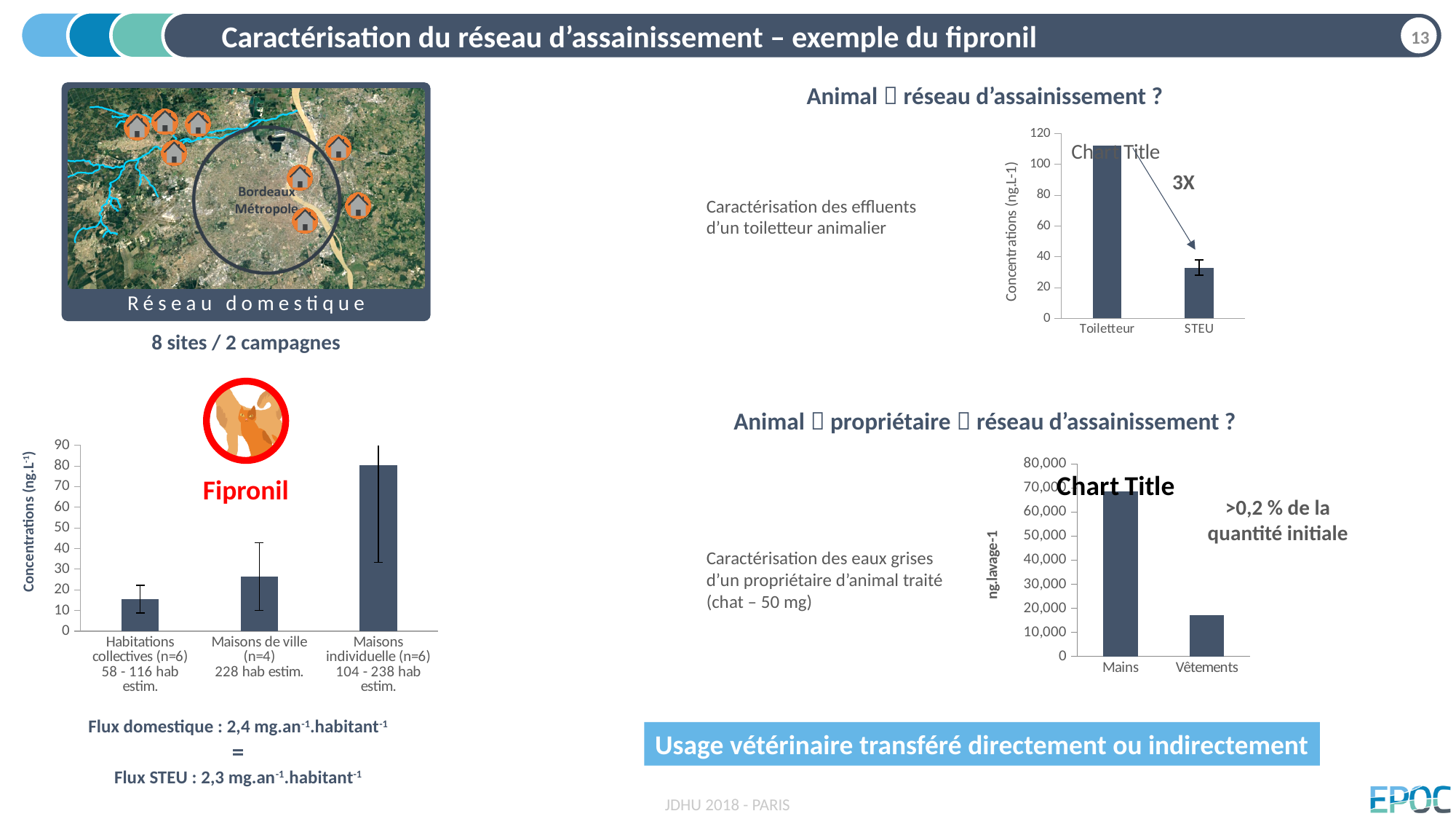
How many categories are shown in the bottom-left chart? 3 In the top-right chart, is the value for Toiletteur greater or less than 100? greater In the top-right chart, which category has the higher concentration, Toiletteur or STEU? Toiletteur What type of chart is the bottom-left chart? bar chart In the top-right chart, is the value for STEU greater or less than 40? less In the bottom-right chart, which category has the higher value, Mains or Vêtements? Mains In the bottom-right chart, is the value for Vêtements greater or less than 20,000? less In the bottom-left chart, which category has the lowest concentration? Habitations collectives (n=6) What is the y-axis label of the bottom-right chart? ng.lavage-1 In the bottom-left chart, which category has the highest concentration? Maisons individuelle (n=6)